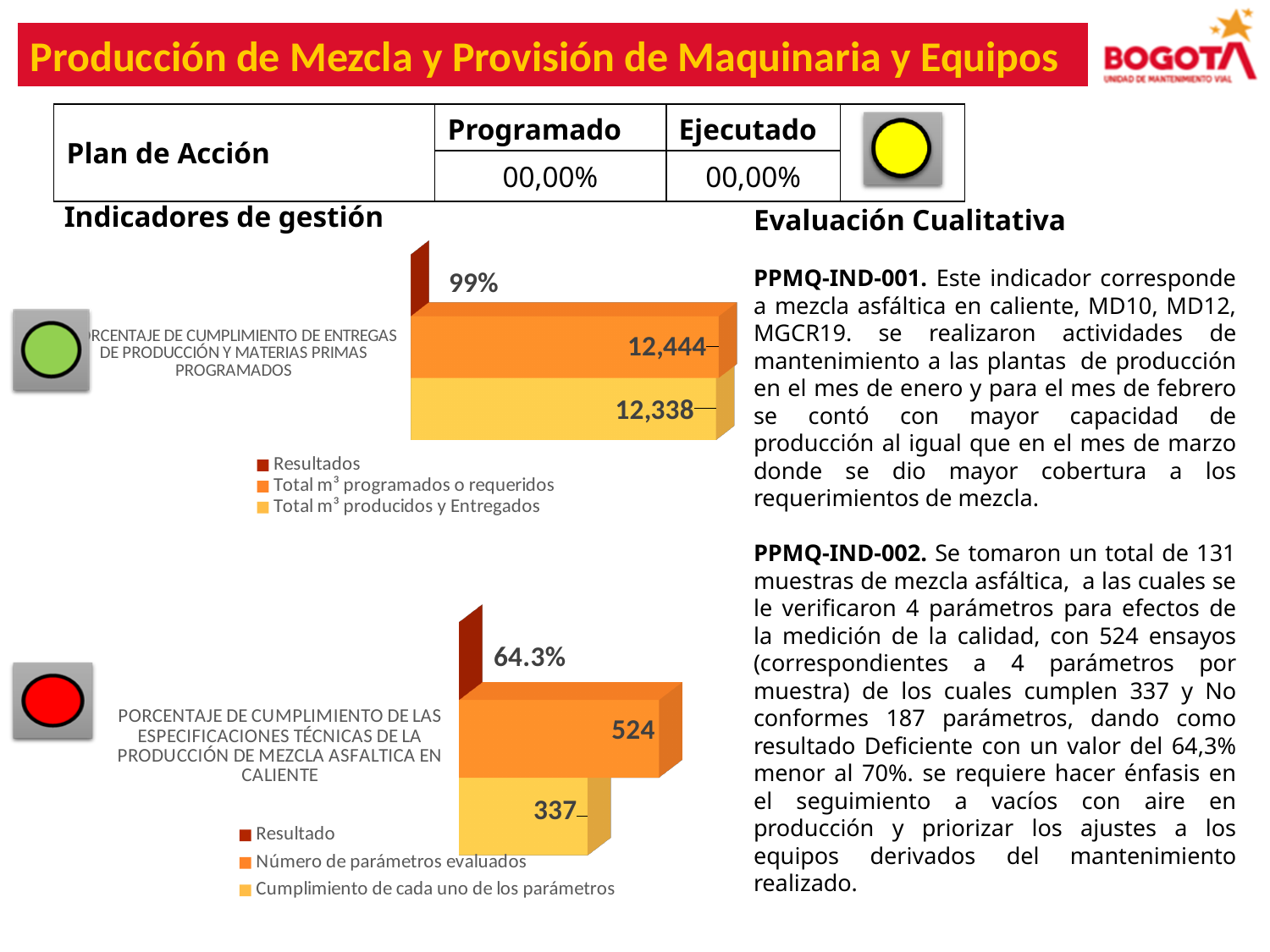
In the bottom chart, what is the value for Cumplimiento de cada uno de los parámetros? 337 In the bottom chart, what is the value for Número de parámetros evaluados? 524 In the bottom chart, what colour is the bar for Cumplimiento de cada uno de los parámetros? Yellow In the top chart, what is the value labelled for Resultados? 99% How many series does the legend of the top chart list? 3 In the top chart, what is the value for Total m³ programados o requeridos? 12,444 In the top chart, what is the value for Total m³ producidos y Entregados? 12,338 In the top chart, what is the difference between Total m³ programados o requeridos and Total m³ producidos y Entregados? 106 In the bottom chart, what is the value labelled for Resultado? 64.3% In the bottom chart, what is the difference between Número de parámetros evaluados and Cumplimiento de cada uno de los parámetros? 187 In the top chart, which is larger: Total m³ programados o requeridos or Total m³ producidos y Entregados? Total m³ programados o requeridos What kind of chart is the bottom chart? Bar chart